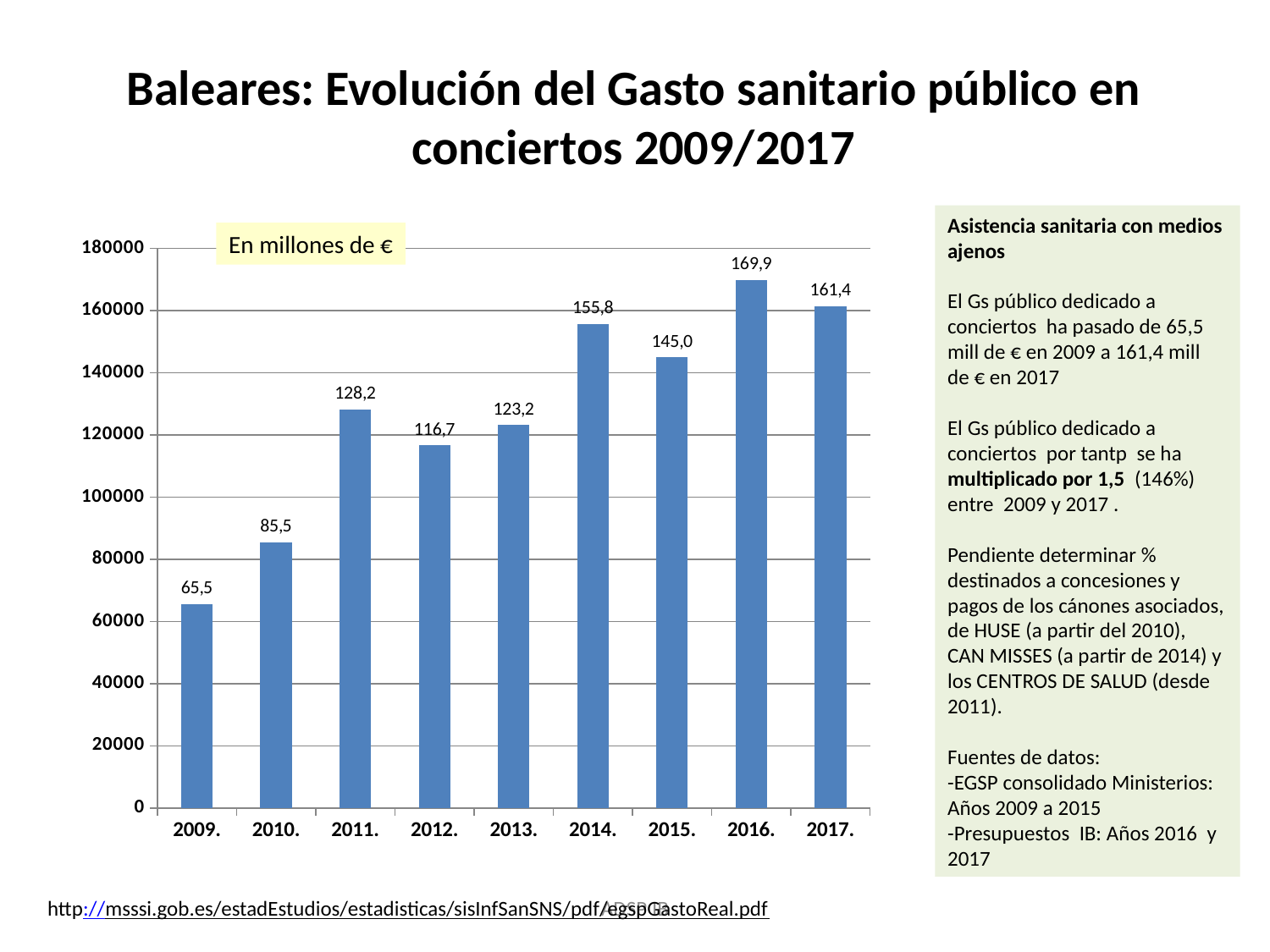
What is the difference between the values for 2016 and 2015? 24,9 Is the bar for 2014 greater or less than 140000 on the axis? greater Which year has the highest value? 2016. Which year has the lowest value? 2009. What is the value shown for 2013? 123,2 How many years are shown on the x axis? 9 What unit does the label box inside the chart state the values are in? En millones de € What is the difference between the values for 2017 and 2009? 95,9 Which is larger, the value for 2011 or the value for 2012? 2011. What is the value shown for 2009? 65,5 What is the value shown for 2017? 161,4 What type of chart is shown on the slide? bar chart